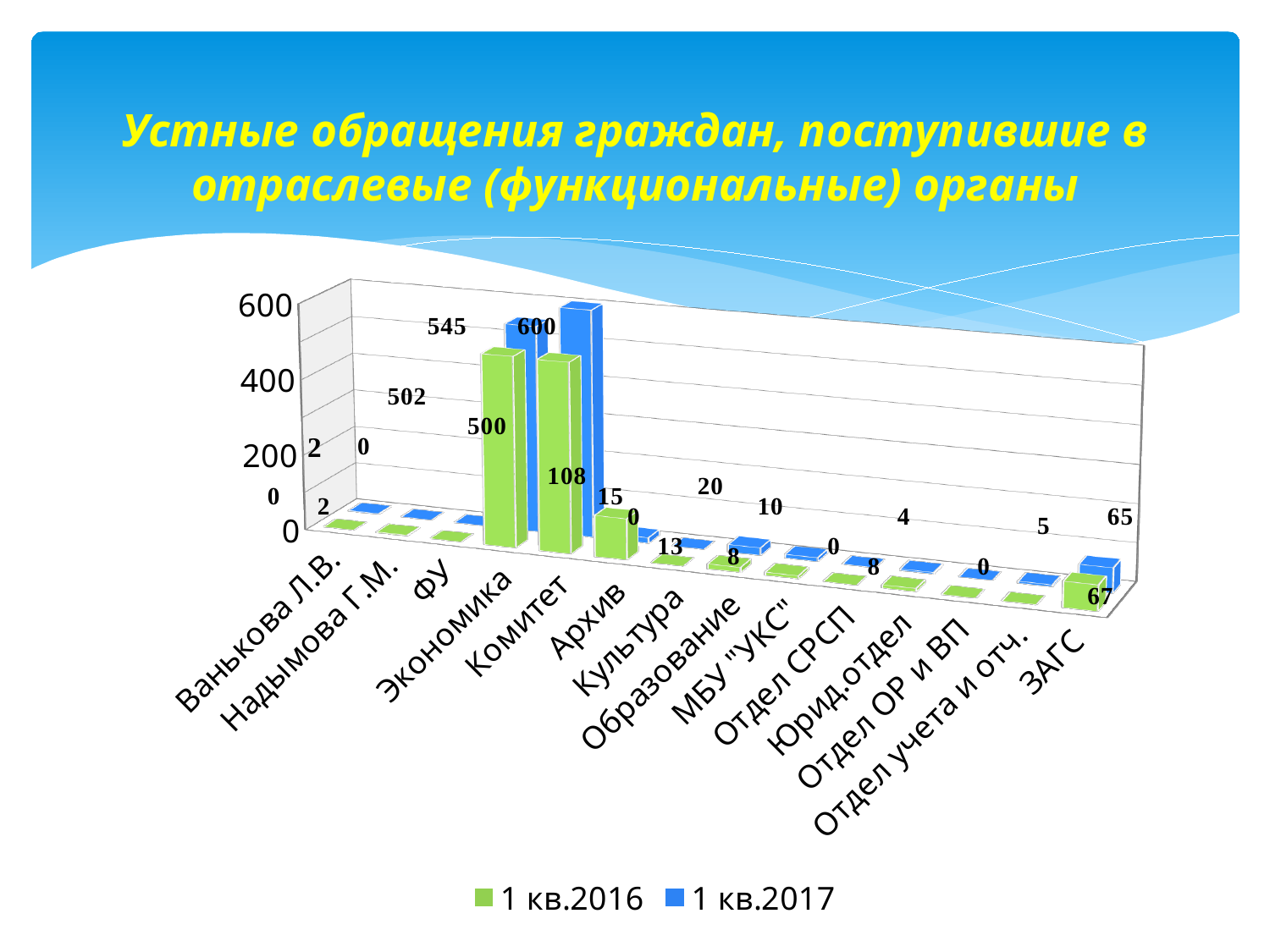
Which is larger for 1 кв.2016: Экономика or Архив? Экономика What is the value for Экономика in 1 кв.2016? 502 Which category has the highest value for 1 кв.2017? Комитет Is the value for ЗАГС in 1 кв.2017 greater or less than 200? less Is the value for Экономика in 1 кв.2016 greater or less than 400? greater How many categories are shown along the x axis? 14 Is the value for Архив in 1 кв.2016 greater or less than 200? less What kind of chart is shown on the slide? bar chart What are the two series named in the legend? 1 кв.2016 and 1 кв.2017 What is the title of the chart? Устные обращения граждан, поступившие в отраслевые (функциональные) органы What is the value for Комитет in 1 кв.2017? 600 How many series does the legend list? 2